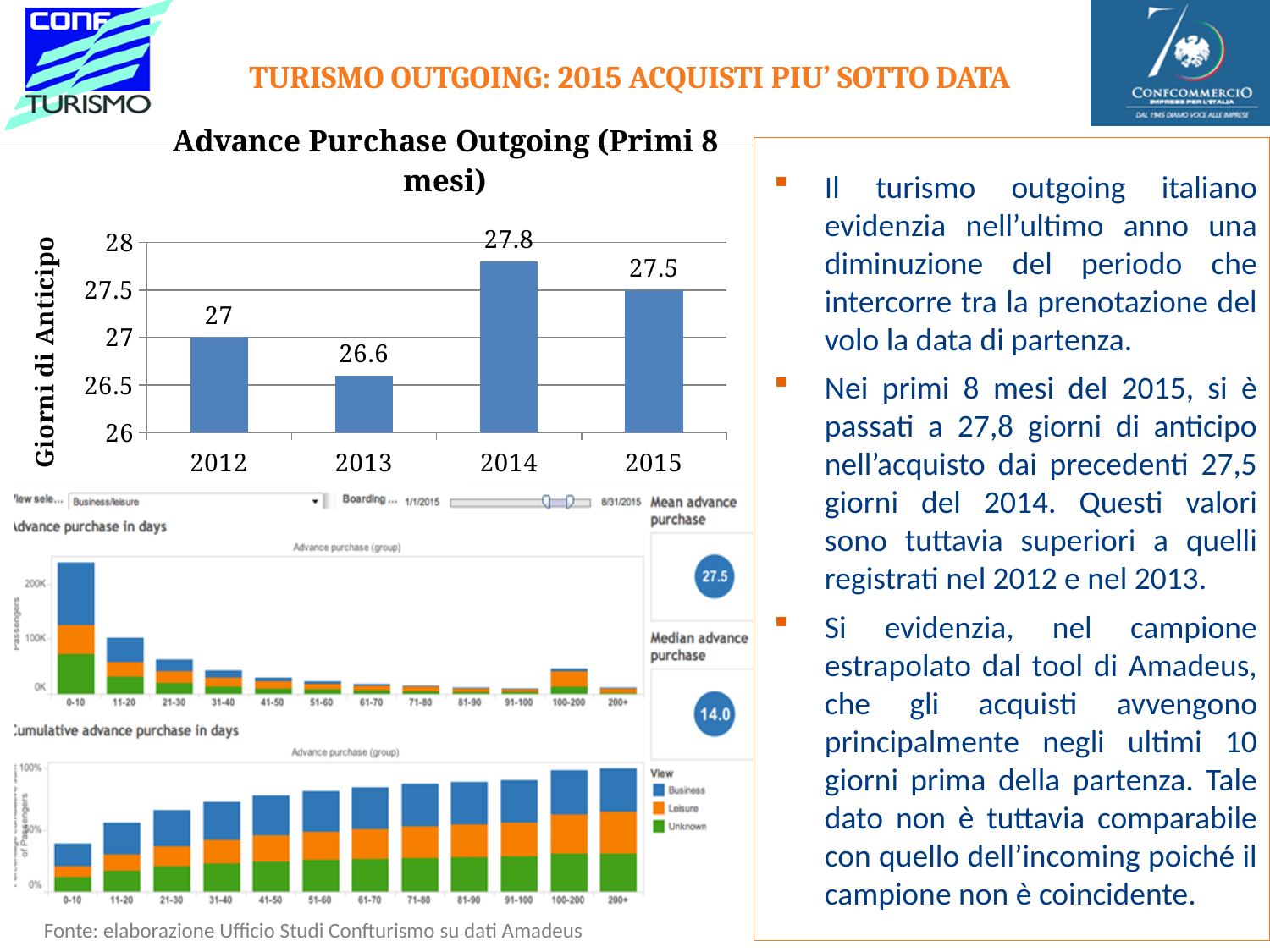
In the 'Advance Purchase Outgoing (Primi 8 mesi)' chart, what is the label of the vertical axis? Giorni di Anticipo In the 'Advance Purchase Outgoing (Primi 8 mesi)' chart, which year has the highest value? 2014 In the 'Advance Purchase Outgoing (Primi 8 mesi)' chart, which year has the lowest value? 2013 In the 'Advance Purchase Outgoing (Primi 8 mesi)' chart, what is the value for 2013? 26.6 In the 'Advance Purchase Outgoing (Primi 8 mesi)' chart, what is the value for 2012? 27 In the 'Advance Purchase Outgoing (Primi 8 mesi)' chart, what is the difference between the 2014 and 2013 values? 1.2 In the 'Advance Purchase Outgoing (Primi 8 mesi)' chart, which is larger, the value for 2012 or the value for 2015? 2015 What kind of chart is 'Advance Purchase Outgoing (Primi 8 mesi)'? Bar chart In the 'Advance Purchase Outgoing (Primi 8 mesi)' chart, how many years are shown on the x axis? 4 In the Amadeus screenshot at the bottom left, how many series does the 'View' legend list? 3 In the Amadeus screenshot at the bottom left, what is the 'Mean advance purchase' value shown? 27.5 In the 'Advance Purchase Outgoing (Primi 8 mesi)' chart, what is the value for 2015? 27.5